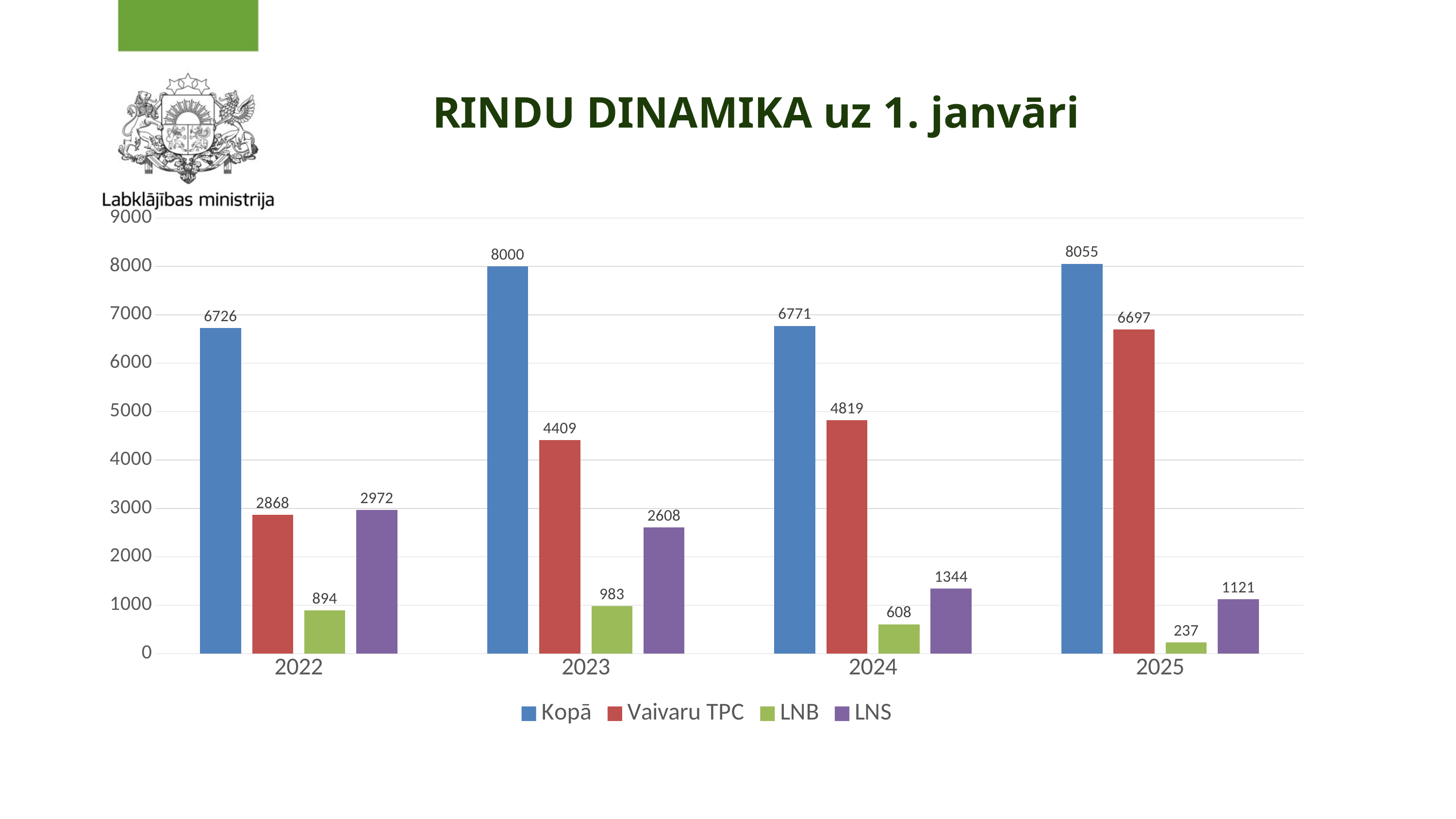
What kind of chart is shown on the slide? bar chart What is the value for Kopā in 2023? 8000 Does the Vaivaru TPC value rise or fall from 2022 to 2025? rise What is the value for LNB in 2024? 608 What is the value for Vaivaru TPC in 2025? 6697 What is the value for LNS in 2022? 2972 In which year is the Kopā value highest? 2025 What is the difference between the Vaivaru TPC values in 2025 and 2024? 1878 How many years are shown on the x axis? 4 In which year is the LNB value lowest? 2025 Which is larger in 2022, Vaivaru TPC or LNS? LNS How many series does the legend list? 4